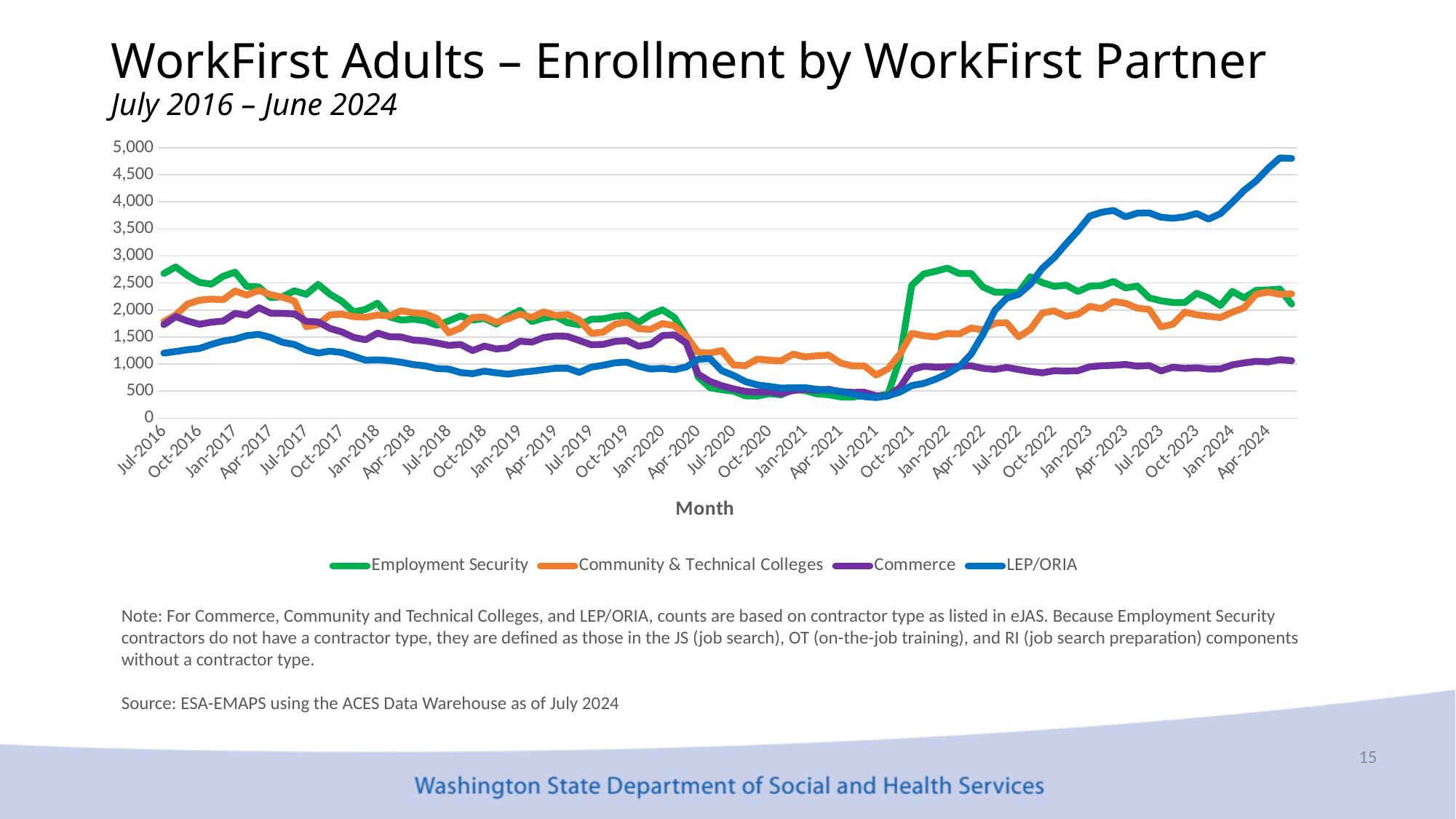
At Jan-2019, which series has the higher value, Commerce or LEP/ORIA? Commerce Is the value for Commerce at Apr-2024 greater or less than 1,500? less Is the value for LEP/ORIA at Apr-2024 greater or less than 4,000? greater Which series reaches the highest value anywhere on the chart? LEP/ORIA How many series does the legend list? 4 What kind of chart is shown on the slide? line chart Is the value for Employment Security at Jan-2021 greater or less than 1,000? less At Jul-2016, which series has the higher value, Employment Security or LEP/ORIA? Employment Security Which series are listed in the legend? Employment Security, Community & Technical Colleges, Commerce, LEP/ORIA What is the title of the x axis? Month At Apr-2024, which series has the higher value, LEP/ORIA or Commerce? LEP/ORIA